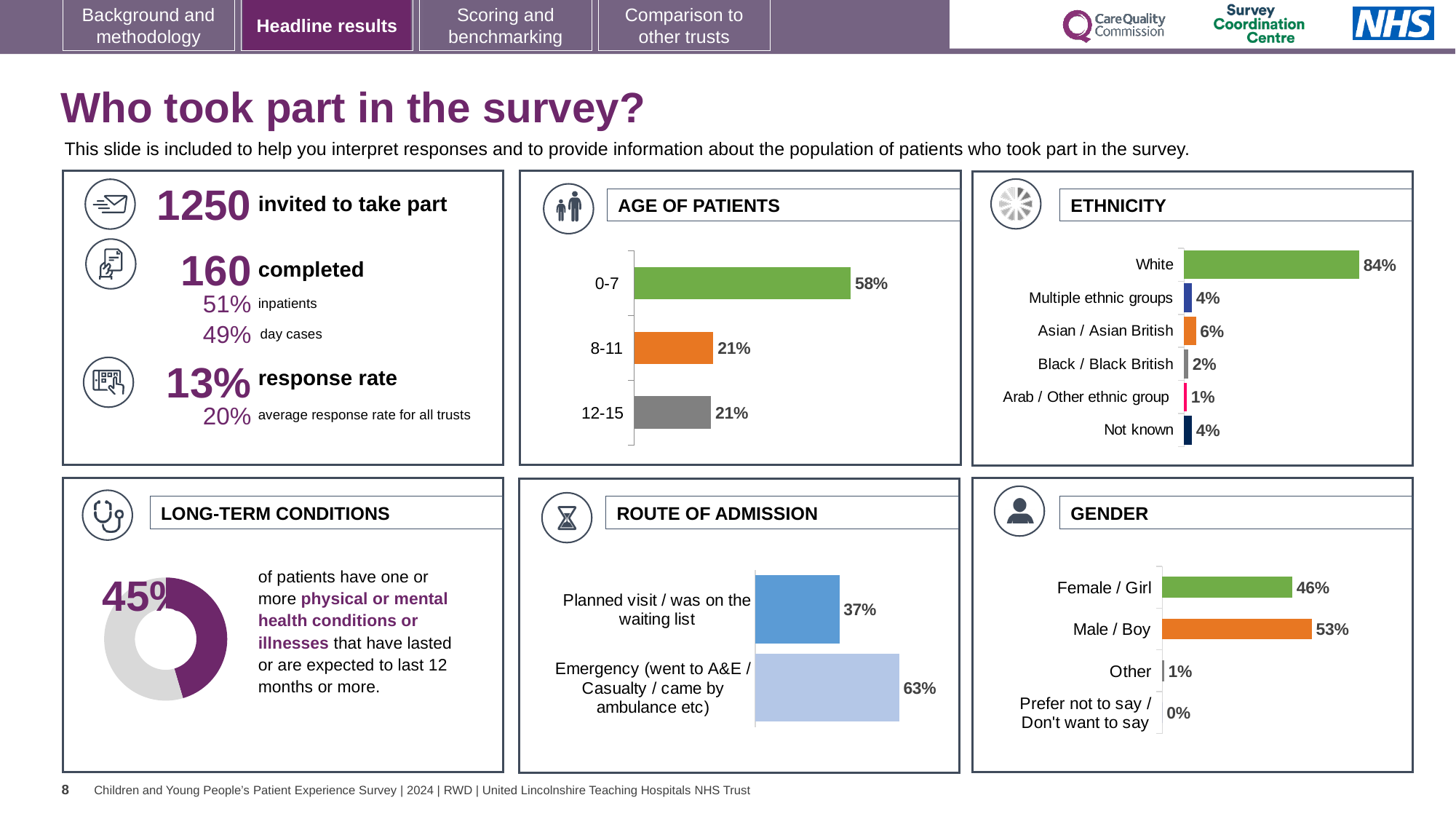
In the ETHNICITY chart, which is larger: Asian / Asian British or Black / Black British? Asian / Asian British In the GENDER chart, which category has the highest value? Male / Boy In the AGE OF PATIENTS chart, what percentage of patients were aged 0-7? 58% What type of chart is used in the LONG-TERM CONDITIONS panel? Doughnut chart In the ETHNICITY chart, what percentage of patients were White? 84% In the ROUTE OF ADMISSION chart, what is the difference between the Emergency and Planned visit values? 26 percentage points In the GENDER chart, what percentage of patients were Male / Boy? 53% In the ROUTE OF ADMISSION chart, what percentage of patients came via Emergency (went to A&E / Casualty / came by ambulance etc)? 63% How many categories are shown in the ETHNICITY chart? 6 In the ETHNICITY chart, which category has the lowest value? Arab / Other ethnic group In the AGE OF PATIENTS chart, what is the difference between the 0-7 group and the 8-11 group? 37 percentage points In the AGE OF PATIENTS chart, which age group has the highest value? 0-7